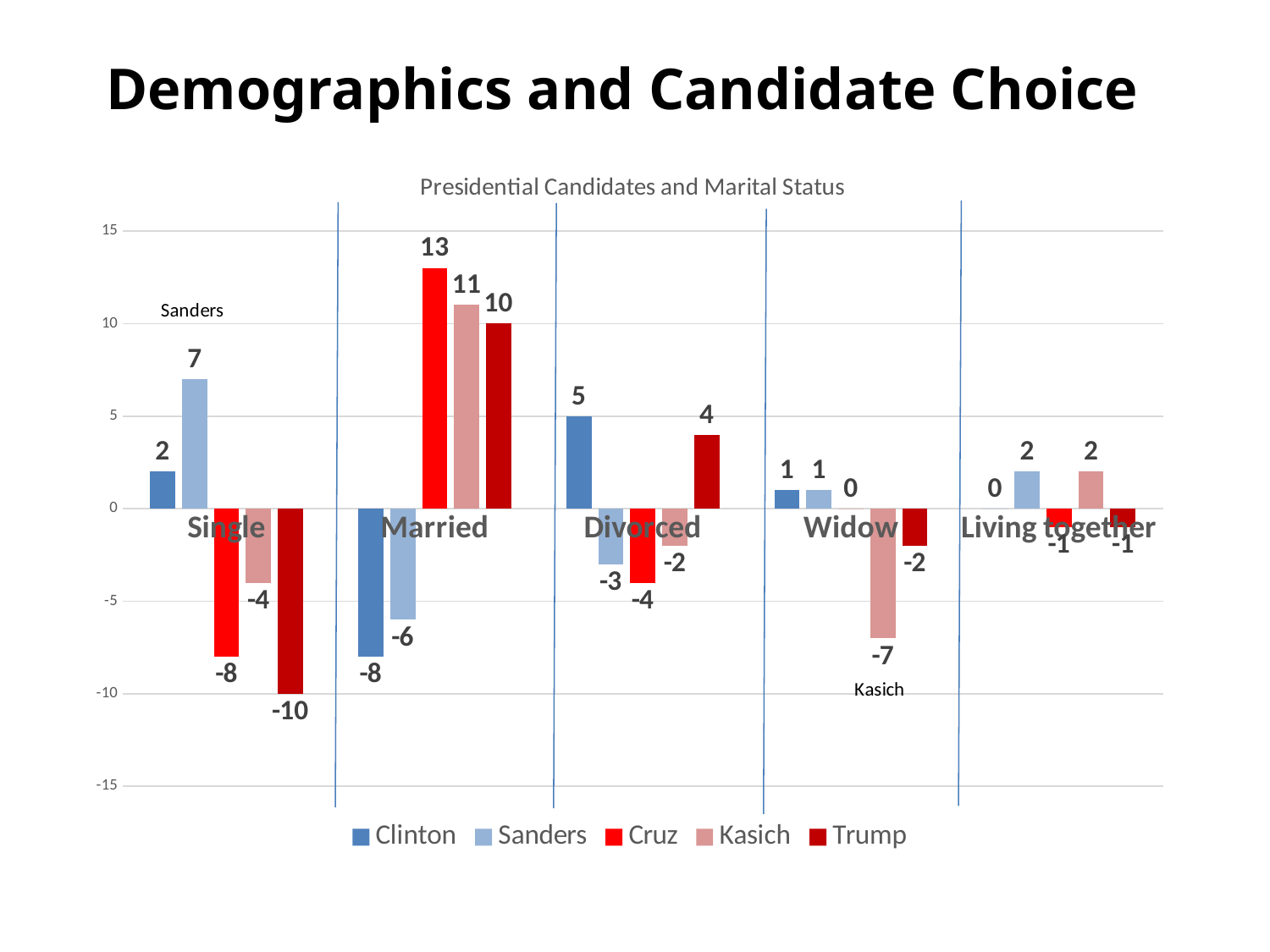
What is the value for Kasich in the Widow category? -7 What is the title of the chart? Presidential Candidates and Marital Status In the Divorced category, which is larger: the value for Clinton or the value for Trump? Clinton How many marital status categories are shown on the x axis? 5 What is the difference between Cruz's and Trump's values in the Married category? 3 What is the value for Clinton in the Divorced category? 5 Which candidate has the highest value in the Married category? Cruz Which candidate has the lowest value in the Single category? Trump What is the value for Trump in the Single category? -10 What kind of chart is shown on the slide? Bar chart What is the value for Cruz in the Married category? 13 How many series does the legend list? 5